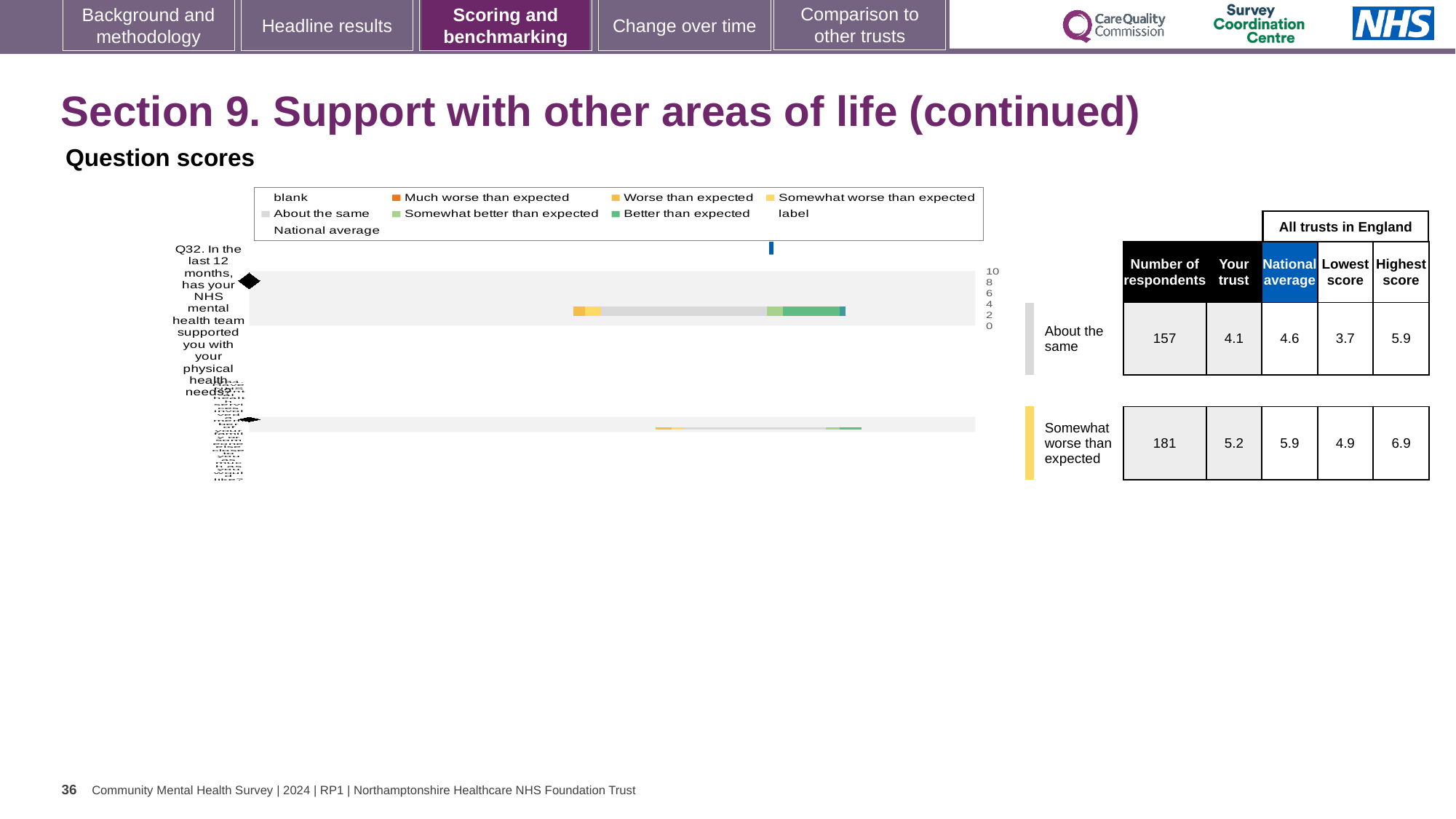
What kind of chart is used to show the question scores? Bar chart For Q32, which is larger: the trust's score or the national average? National average Which benchmark category is Q32 rated as? About the same What is the lowest score among all trusts in England for Q32? 3.7 How many respondents answered Q32? 157 What is the difference between the highest and lowest trust scores for Q32? 2.2 For the question rated 'Somewhat worse than expected', how much higher is the national average than the trust's score? 0.7 What is the national average score for Q32? 4.6 What does the blue marker on the chart represent, according to the legend? National average What is the 'Your trust' score for the question rated 'Somewhat worse than expected'? 5.2 What is the 'Your trust' score for Q32 (support with physical health needs)? 4.1 What is the highest score among all trusts in England for Q32? 5.9